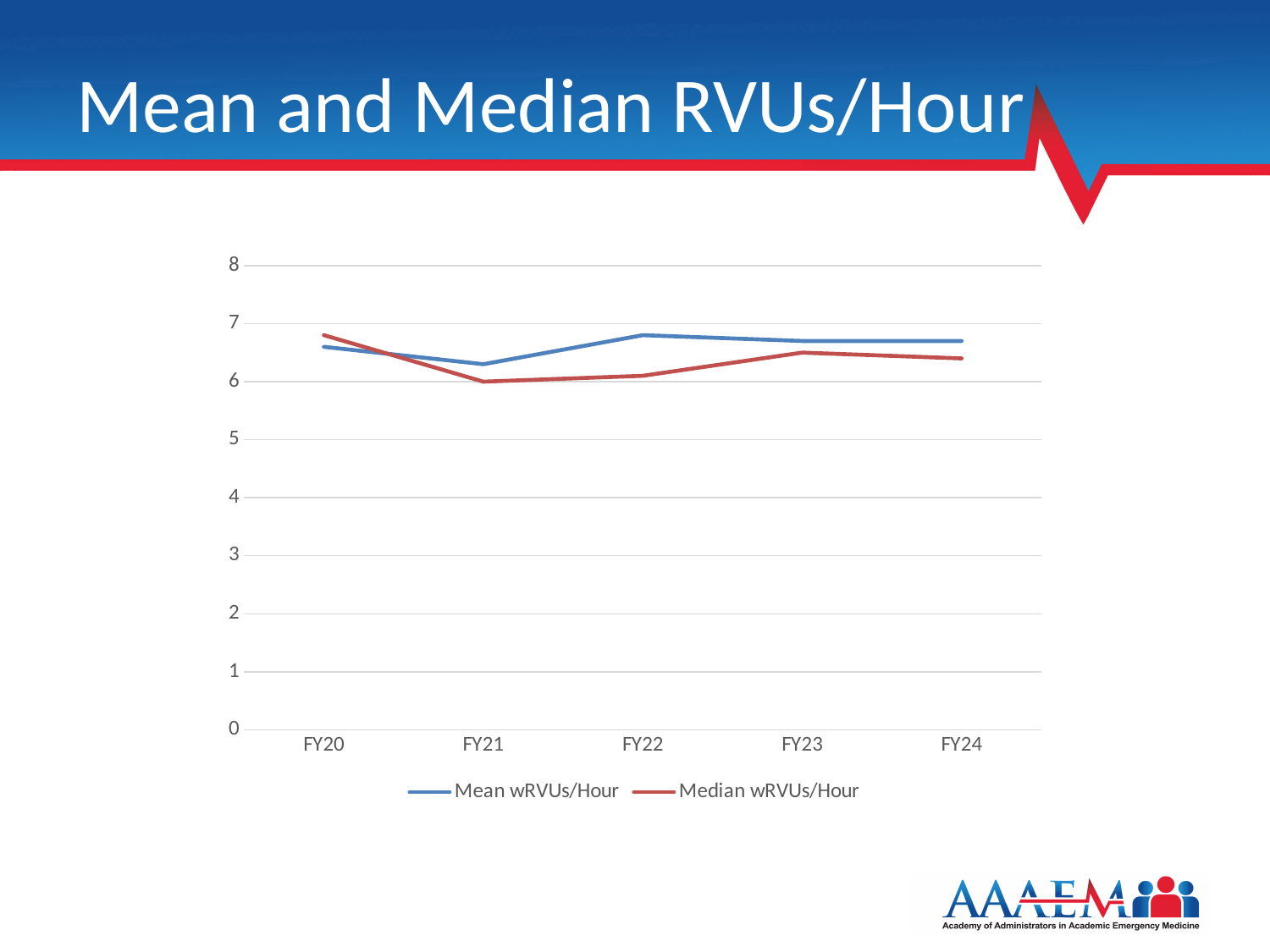
How many series does the legend list? 2 Is the value for Mean wRVUs/Hour in FY22 greater or less than 7? less What colour is the line for Median wRVUs/Hour? Red Is the value for Mean wRVUs/Hour in FY21 greater or less than 6? greater Which fiscal year has the lowest value for Mean wRVUs/Hour? FY21 Is the value for Median wRVUs/Hour in FY20 greater or less than 7? less In FY22, which is larger: Mean wRVUs/Hour or Median wRVUs/Hour? Mean wRVUs/Hour In FY21, which is larger: Mean wRVUs/Hour or Median wRVUs/Hour? Mean wRVUs/Hour What kind of chart is shown on the slide? Line chart Does the Median wRVUs/Hour line rise or fall from FY20 to FY21? Fall How many fiscal years are plotted along the x axis? 5 Which fiscal year has the highest value for Median wRVUs/Hour? FY20